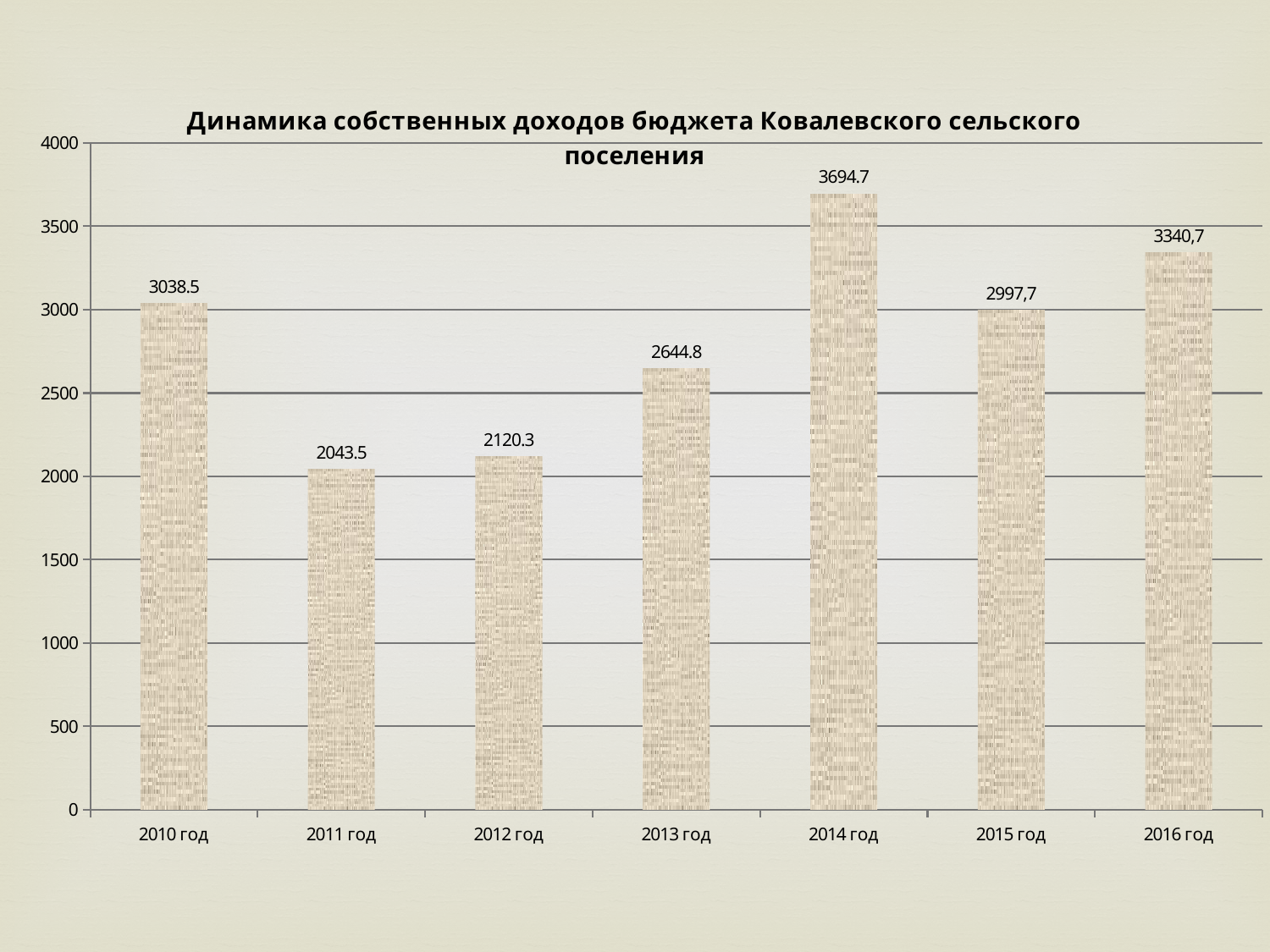
Which is larger, the value for 2010 год or the value for 2015 год? 2010 год Which year has the highest value? 2014 год What is the value for 2011 год? 2043.5 What is the value for 2016 год? 3340,7 What is the value for 2013 год? 2644.8 What is the title of the chart? Динамика собственных доходов бюджета Ковалевского сельского поселения What is the value for 2014 год? 3694.7 What type of chart is shown on the slide? bar chart Which year has the lowest value? 2011 год How many years are shown on the x axis? 7 What is the difference between the values for 2012 год and 2011 год? 76.8 What is the difference between the values for 2014 год and 2011 год? 1651.2